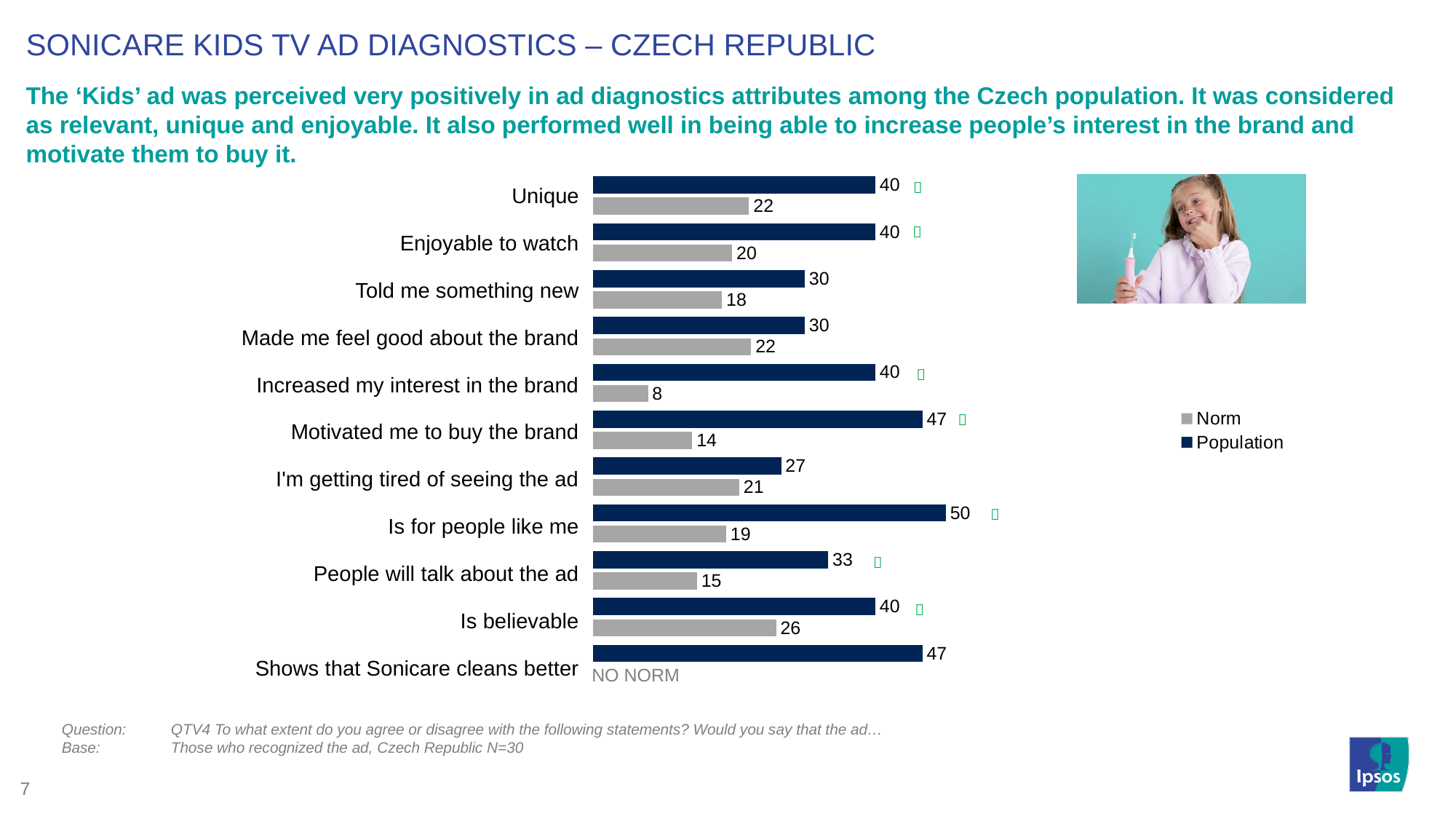
How many statements are listed in the chart? 11 What is the Population value for "Motivated me to buy the brand"? 47 What is the Population value for "Is for people like me"? 50 Which statement has the lowest Population value? I'm getting tired of seeing the ad What kind of chart is shown on the slide? Bar chart Which statement has the lowest Norm value? Increased my interest in the brand What is shown in place of the Norm bar for "Shows that Sonicare cleans better"? NO NORM What is the difference between the Population and Norm values for "Motivated me to buy the brand"? 33 Which is larger for "Is believable": the Population value or the Norm value? Population How many series does the legend list? 2 What is the Norm value for "Increased my interest in the brand"? 8 Which statement has the highest Population value? Is for people like me